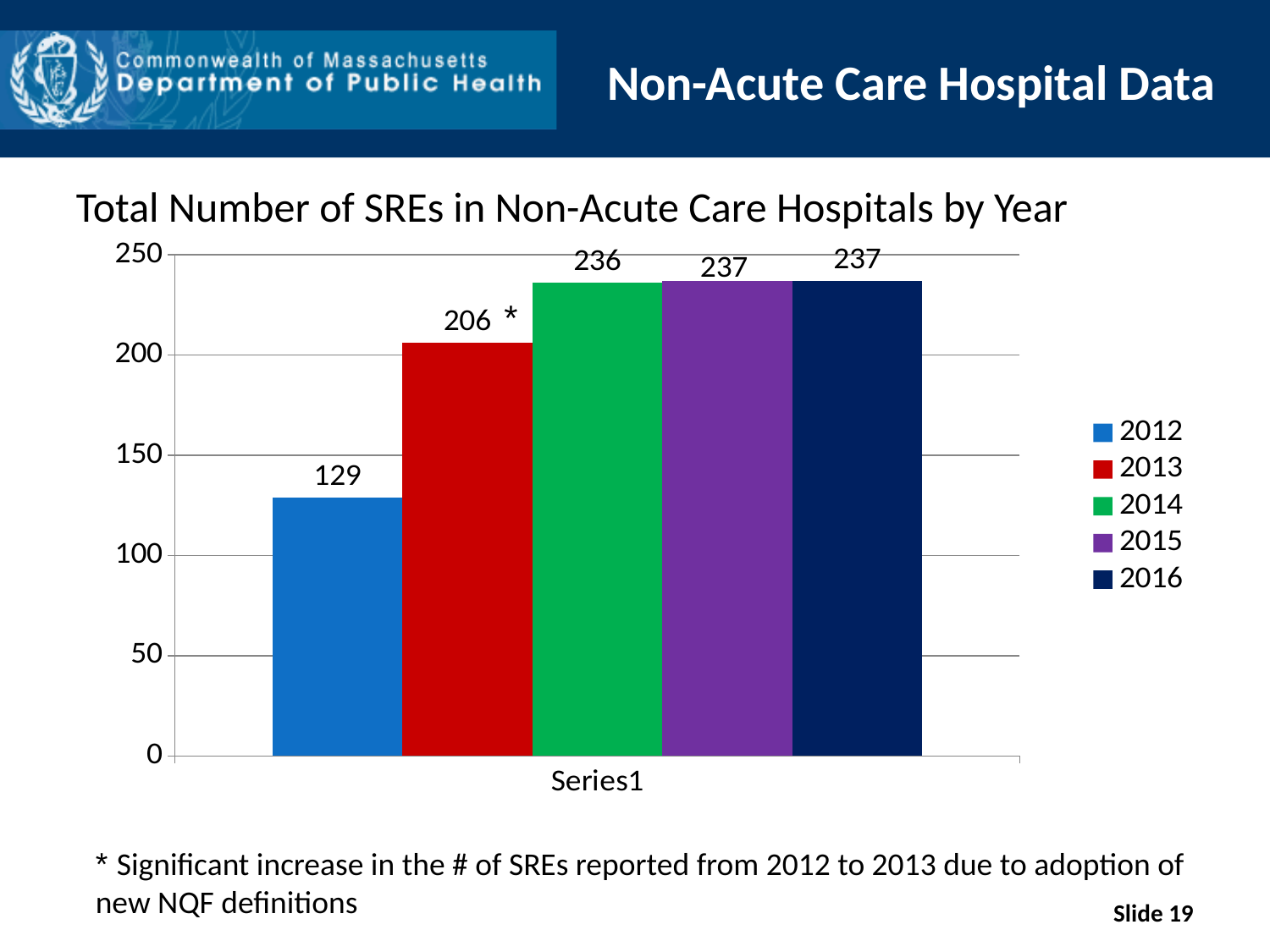
Which year has the lowest total number of SREs? 2012 What kind of chart is shown on the slide? Bar chart How many years are shown in the legend? 5 What is the difference in the number of SREs between 2014 and 2013? 30 What is the total number of SREs in non-acute care hospitals for 2014? 236 What is the total number of SREs in non-acute care hospitals for 2016? 237 What is the total number of SREs in non-acute care hospitals for 2012? 129 What is the total number of SREs in non-acute care hospitals for 2013? 206 Is the value for 2012 greater or less than 150? less Which year had more SREs, 2012 or 2013? 2013 What is the difference in the number of SREs between 2013 and 2012? 77 What is the title of the chart? Total Number of SREs in Non-Acute Care Hospitals by Year